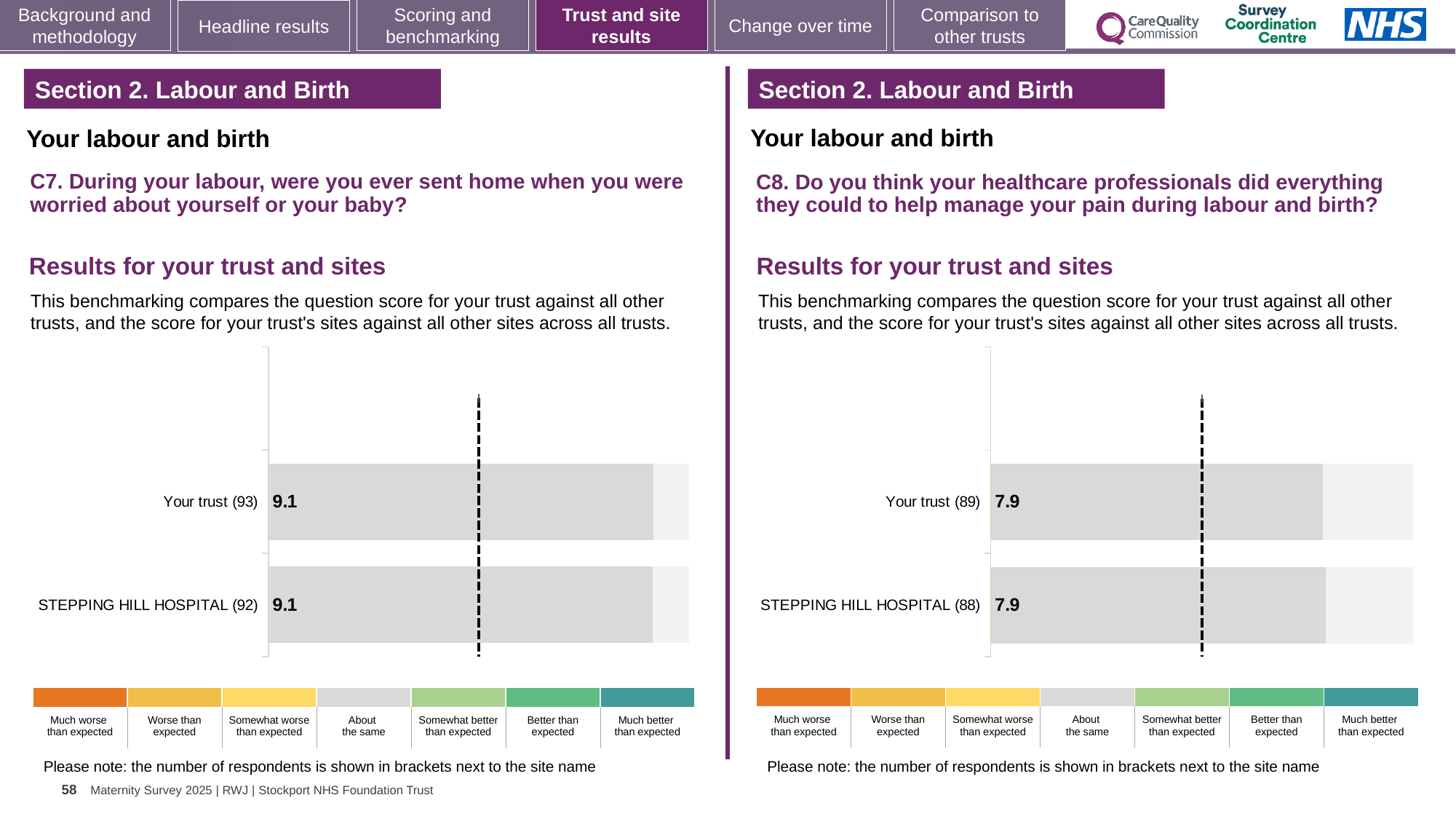
In the right chart (C8), what is the difference between the Your trust score and the STEPPING HILL HOSPITAL score? 0 How many bars are plotted in the left chart (C7)? 2 In the right chart (C8), what is the score for Your trust? 7.9 What kind of chart is used for the C7 results on the left? Bar chart In the right chart (C8), what is the score for STEPPING HILL HOSPITAL? 7.9 How many bars are plotted in the right chart (C8)? 2 How many categories does the colour legend below each chart list? 7 In the right chart (C8), how many respondents are shown in brackets for STEPPING HILL HOSPITAL? 88 In the left chart (C7), what is the score for STEPPING HILL HOSPITAL? 9.1 In the left chart (C7), what is the score for Your trust? 9.1 In the left chart (C7), what is the difference between the Your trust score and the STEPPING HILL HOSPITAL score? 0 In the left chart (C7), how many respondents are shown in brackets for Your trust? 93